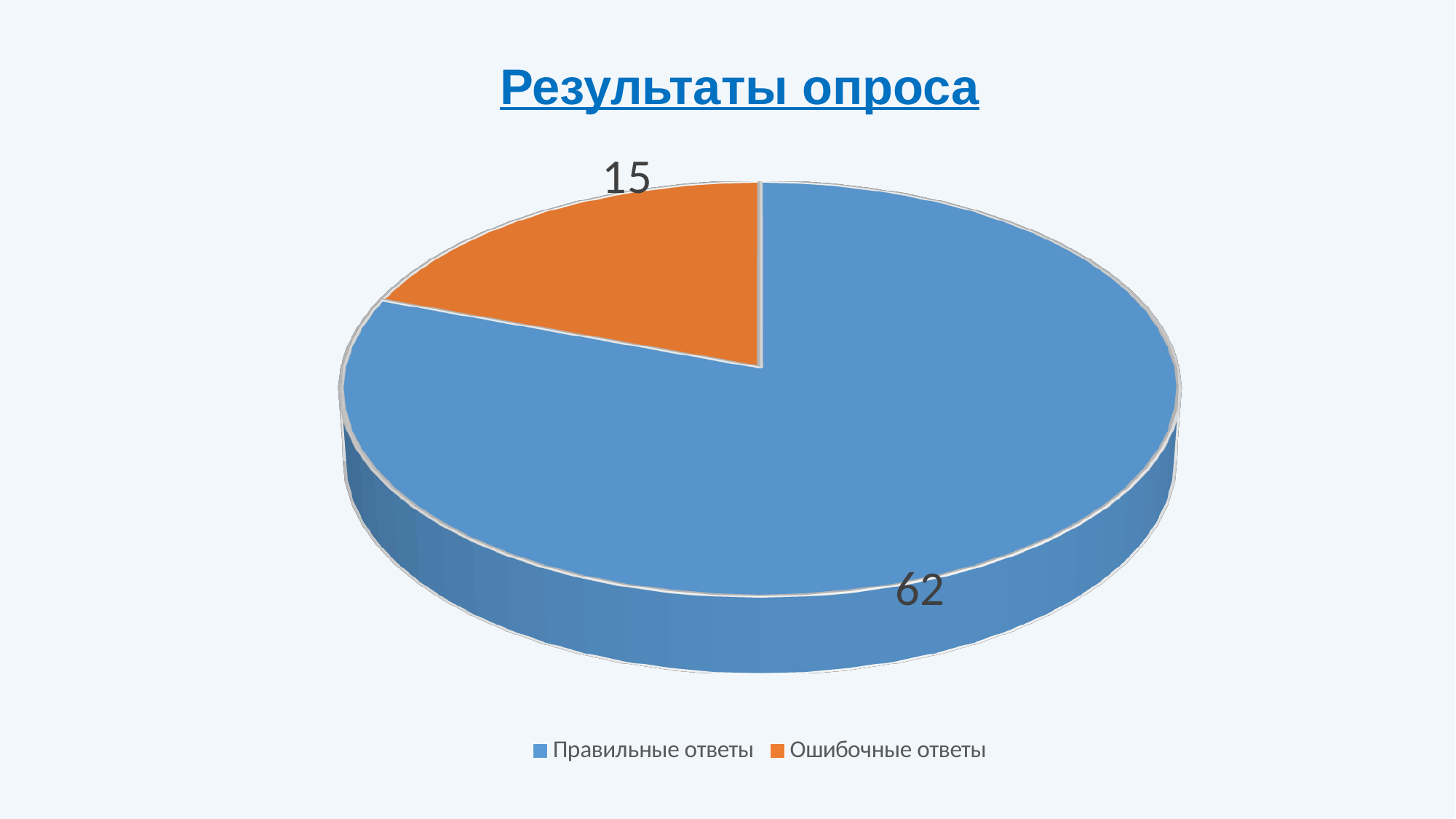
How many entries does the legend list? 2 What kind of chart is shown on the slide? pie chart How many slices does the pie chart have? 2 Which is larger, Правильные ответы or Ошибочные ответы? Правильные ответы What is the difference between the values for Правильные ответы and Ошибочные ответы? 47 Which category has the smallest slice? Ошибочные ответы What is the total of all slices in the pie chart? 77 What is the value for Правильные ответы? 62 What is the title of the slide? Результаты опроса Which category has the largest slice? Правильные ответы What is the value for Ошибочные ответы? 15 What colour is the slice for Ошибочные ответы? orange